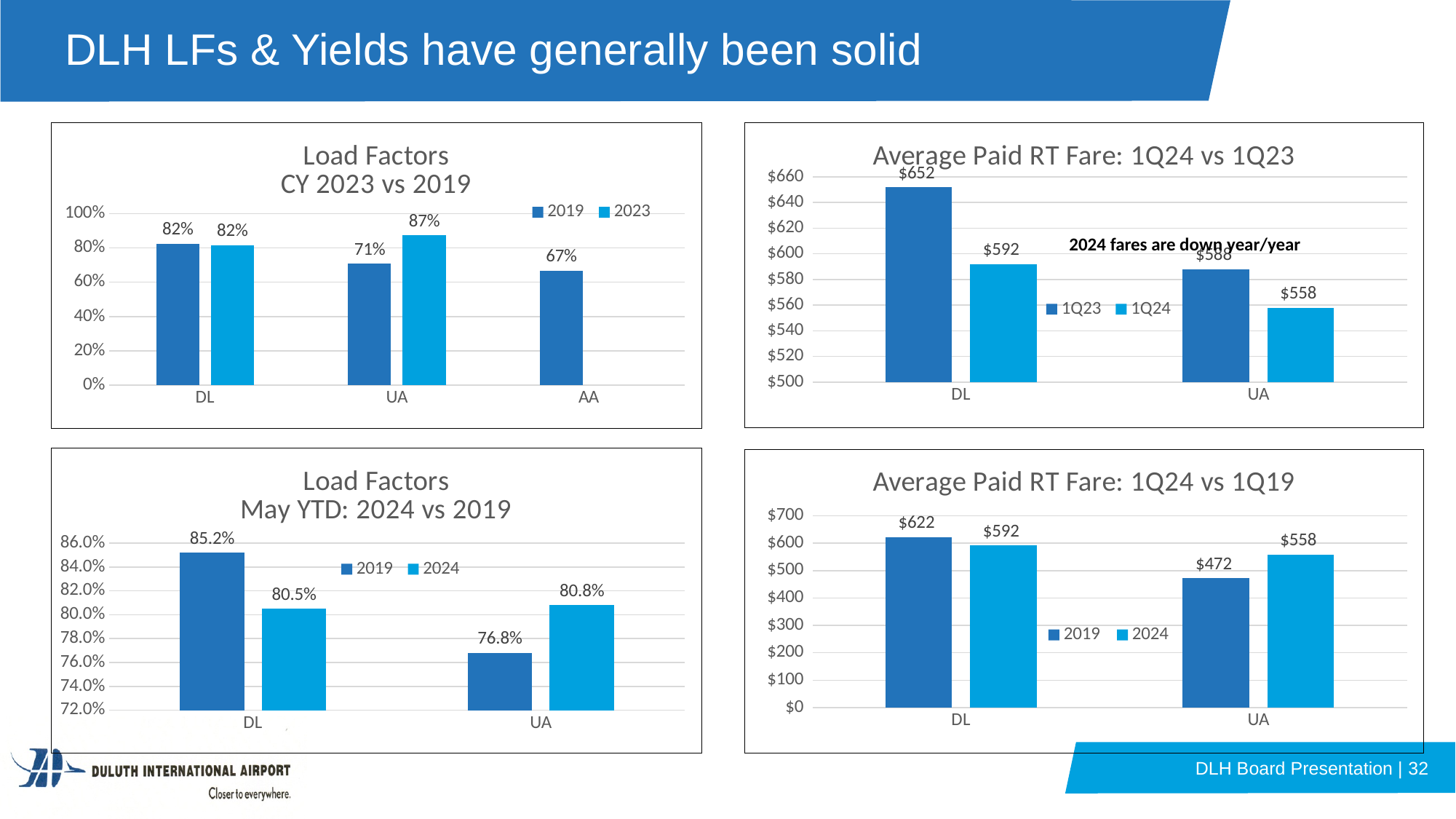
In the 'Average Paid RT Fare: 1Q24 vs 1Q23' chart, what is the 1Q23 fare for DL? $652 In the 'Load Factors May YTD: 2024 vs 2019' chart, what is the 2019 load factor for UA? 76.8% In the 'Average Paid RT Fare: 1Q24 vs 1Q19' chart, what is the difference between the UA 2024 and 2019 fares? $86 What type of chart is the 'Average Paid RT Fare: 1Q24 vs 1Q19' chart? Bar chart In the 'Load Factors May YTD: 2024 vs 2019' chart, which is larger for DL: the 2019 or the 2024 load factor? 2019 In the 'Load Factors CY 2023 vs 2019' chart, what is the 2023 load factor for UA? 87% In the 'Average Paid RT Fare: 1Q24 vs 1Q23' chart, which airline has the lowest 1Q24 fare? UA In the 'Load Factors CY 2023 vs 2019' chart, what is the 2019 load factor for AA? 67% In the 'Average Paid RT Fare: 1Q24 vs 1Q19' chart, what is the 2019 fare for UA? $472 In the 'Load Factors CY 2023 vs 2019' chart, how many airline categories are shown on the x axis? 3 In the 'Average Paid RT Fare: 1Q24 vs 1Q23' chart, what is the difference between the DL 1Q23 and 1Q24 fares? $60 In the 'Load Factors May YTD: 2024 vs 2019' chart, how many series does the legend list? 2